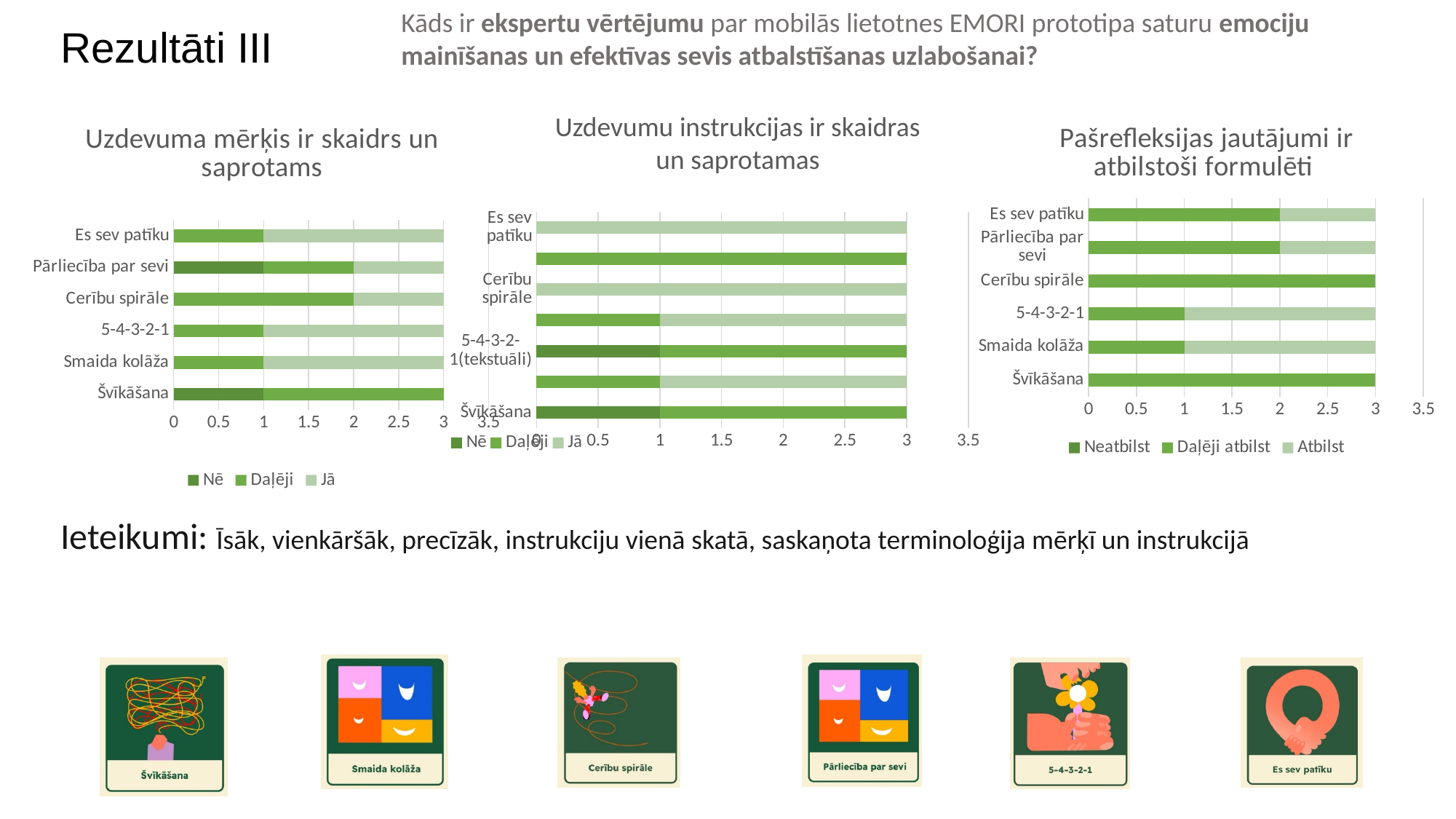
In the chart titled "Uzdevuma mērķis ir skaidrs un saprotams", what is the total of the stacked bar for "Pārliecība par sevi"? 3 In the chart titled "Uzdevuma mērķis ir skaidrs un saprotams", how many series does the legend list? 3 In the chart titled "Pašrefleksijas jautājumi ir atbilstoši formulēti", what are the three legend entries? Neatbilst, Daļēji atbilst, Atbilst In the chart titled "Pašrefleksijas jautājumi ir atbilstoši formulēti", what is the "Daļēji atbilst" value for "Cerību spirāle"? 3 What kind of chart is "Uzdevumu instrukcijas ir skaidras un saprotamas"? Stacked bar chart In the chart titled "Uzdevuma mērķis ir skaidrs un saprotams", how many categories are shown? 6 In the chart titled "Uzdevuma mērķis ir skaidrs un saprotams", what is the "Nē" value for "Švīkāšana"? 1 In the chart titled "Pašrefleksijas jautājumi ir atbilstoši formulēti", what is the "Atbilst" value for "5-4-3-2-1"? 2 In the chart titled "Uzdevumu instrukcijas ir skaidras un saprotamas", what is the "Jā" value for "Es sev patīku"? 3 In the chart titled "Uzdevuma mērķis ir skaidrs un saprotams", what is the "Jā" value for "Es sev patīku"? 2 In the chart titled "Uzdevumu instrukcijas ir skaidras un saprotamas", what is the "Daļēji" value for "Švīkāšana"? 2 In the chart titled "Pašrefleksijas jautājumi ir atbilstoši formulēti", which is larger: the "Daļēji atbilst" value for "Es sev patīku" or for "Smaida kolāža"? Es sev patīku